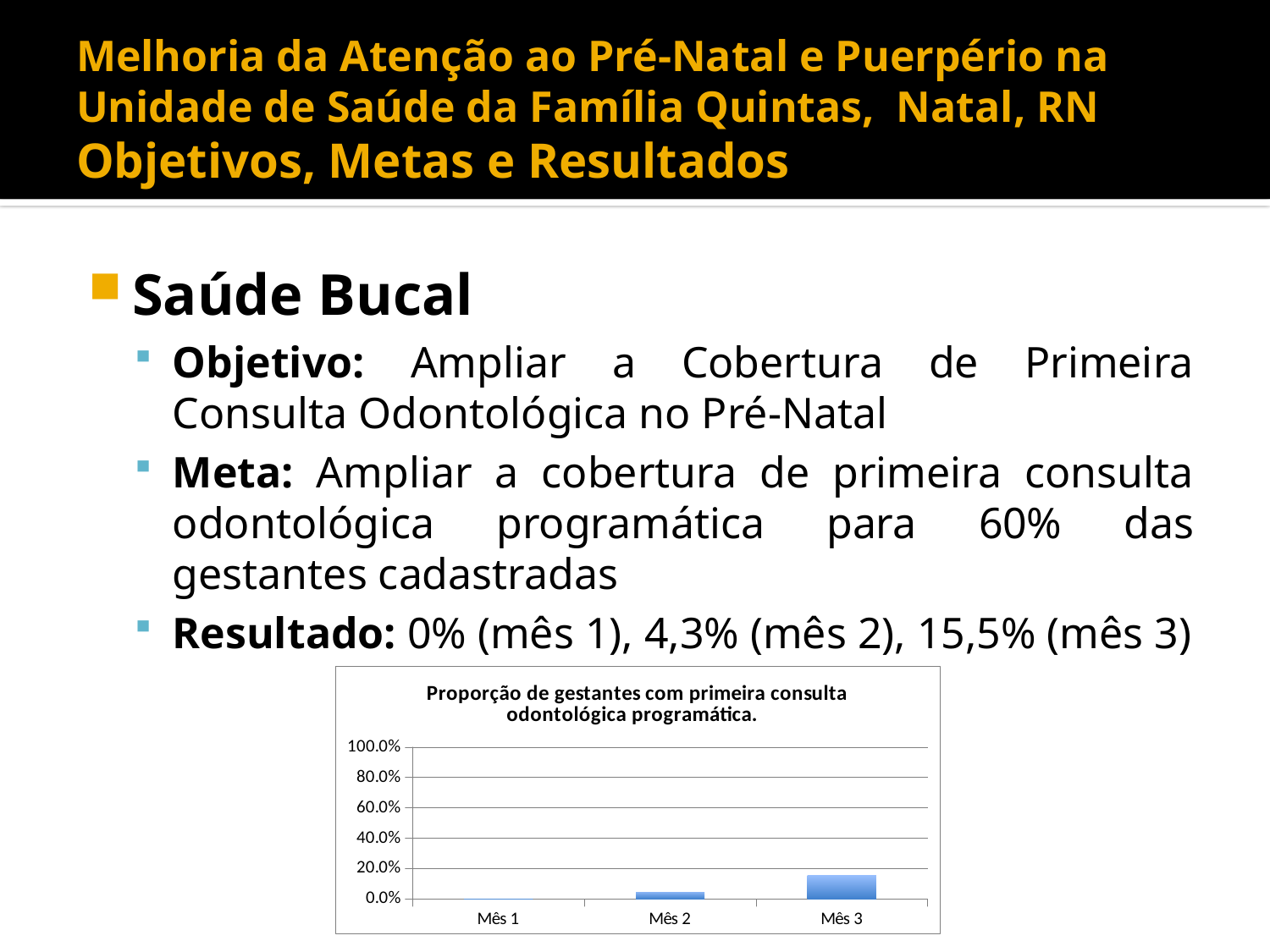
Is the value for Mês 3 greater or less than 40.0%? less What is the title of the chart? Proporção de gestantes com primeira consulta odontológica programática. Which month has the lowest value in the chart? Mês 1 Is the value for Mês 3 greater or less than 20.0%? less Do the values rise or fall from Mês 1 to Mês 3? rise What is the value for Mês 1 in the chart? 0.0% Which month has the highest value in the chart? Mês 3 What is the highest value shown on the y axis of the chart? 100.0% Is the value for Mês 2 greater or less than 20.0%? less How many categories are shown on the x axis of the chart? 3 Which is larger, the value for Mês 2 or the value for Mês 3? Mês 3 What kind of chart is shown on the slide? bar chart